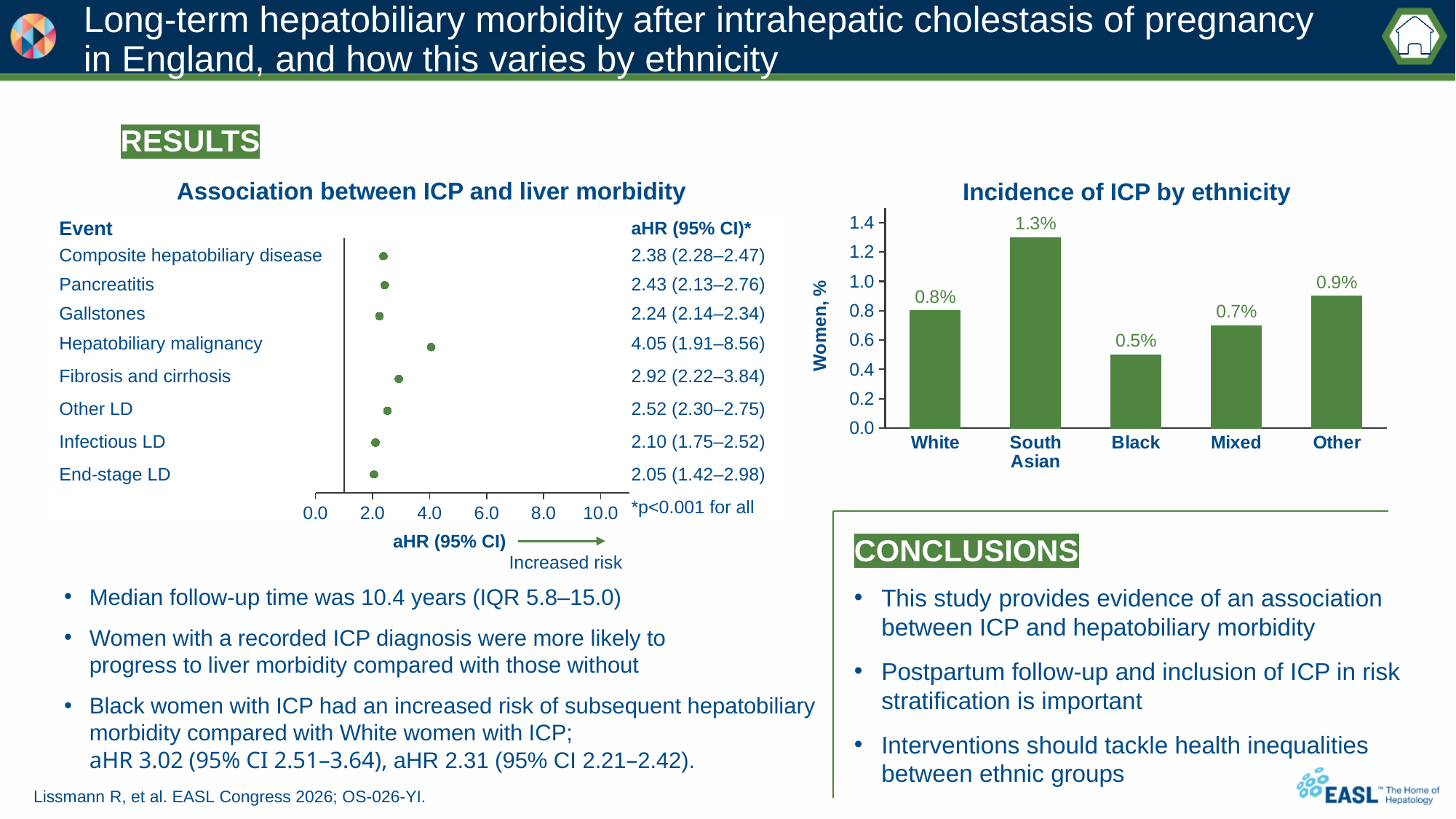
What kind of chart is 'Incidence of ICP by ethnicity'? Bar chart In the 'Incidence of ICP by ethnicity' chart, what is the value for Black women? 0.5% In the 'Association between ICP and liver morbidity' chart, how many events are plotted? 8 In the 'Incidence of ICP by ethnicity' chart, which ethnic group has the lowest incidence? Black In the 'Incidence of ICP by ethnicity' chart, what is the value for South Asian women? 1.3% In the 'Association between ICP and liver morbidity' chart, what is the aHR for Hepatobiliary malignancy? 4.05 (1.91–8.56) In the 'Association between ICP and liver morbidity' chart, which event has the highest aHR? Hepatobiliary malignancy In the 'Incidence of ICP by ethnicity' chart, how many ethnic groups are shown? 5 In the 'Incidence of ICP by ethnicity' chart, which ethnic group has the highest incidence? South Asian In the 'Incidence of ICP by ethnicity' chart, which is larger, the value for Mixed or the value for Other? Other In the 'Incidence of ICP by ethnicity' chart, what is the y-axis label? Women, % In the 'Incidence of ICP by ethnicity' chart, what is the difference between the values for South Asian and White women? 0.5%